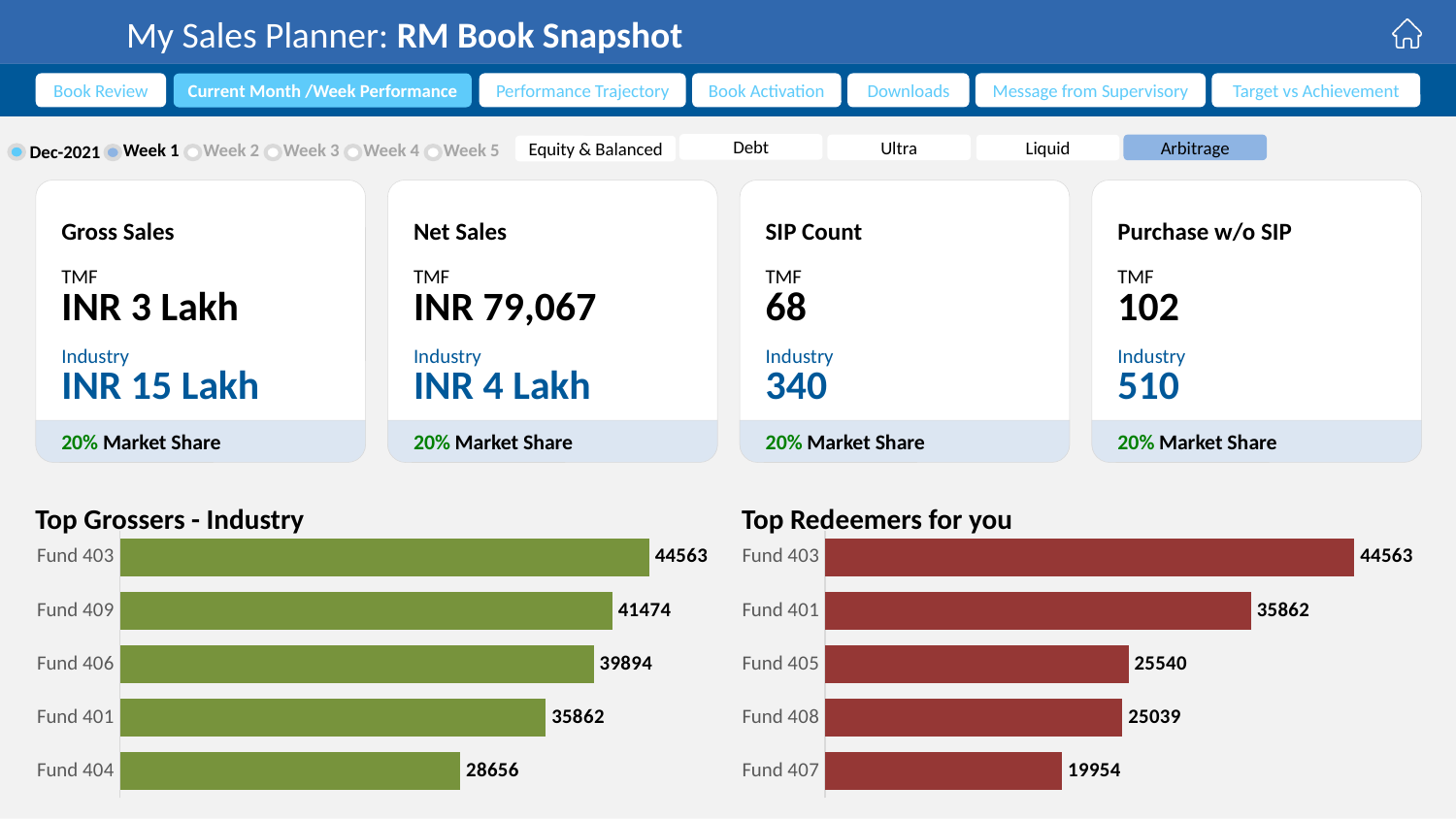
In the 'Top Redeemers for you' chart, what is the value for Fund 407? 19954 In the 'Top Redeemers for you' chart, which is larger, Fund 401 or Fund 407? Fund 401 In the 'Top Grossers - Industry' chart, what is the difference between Fund 403 and Fund 404? 15907 In the 'Top Redeemers for you' chart, which fund has the highest value? Fund 403 In the 'Top Grossers - Industry' chart, which fund has the lowest value? Fund 404 In the 'Top Redeemers for you' chart, what is the value for Fund 405? 25540 What colour are the bars in the 'Top Redeemers for you' chart? Red In the 'Top Grossers - Industry' chart, what is the value for Fund 409? 41474 What type of chart is 'Top Grossers - Industry'? Bar chart In the 'Top Grossers - Industry' chart, how many funds are shown? 5 In the 'Top Redeemers for you' chart, what is the difference between Fund 403 and Fund 401? 8701 In the 'Top Grossers - Industry' chart, what is the value for Fund 406? 39894